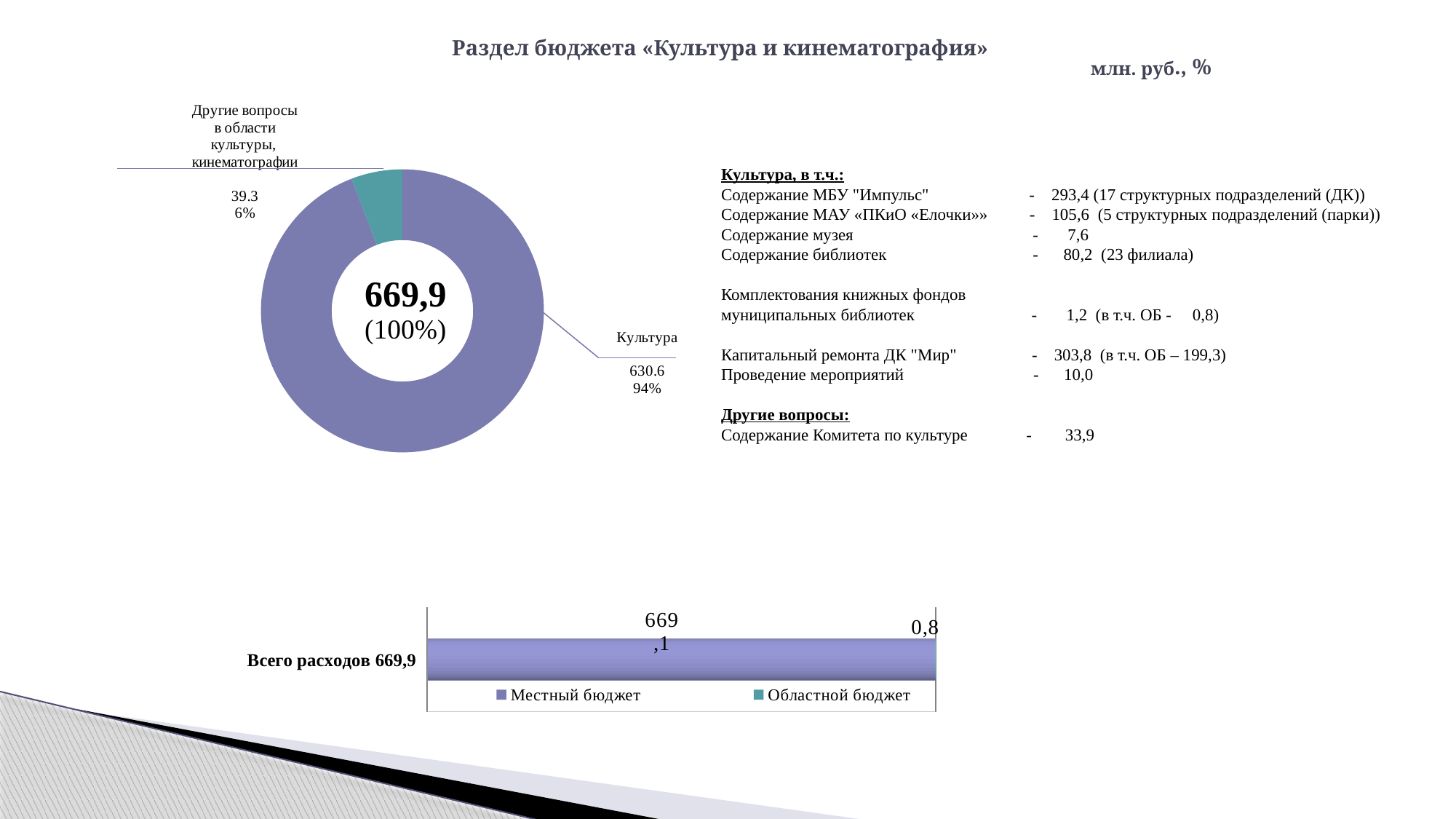
In the doughnut chart at the top left, what value is shown for the slice labelled Другие вопросы в области культуры, кинематографии? 39.3 In the doughnut chart at the top left, which slice is the largest? Культура In the doughnut chart at the top left, what total value is printed in the centre of the ring? 669,9 In the bar chart at the bottom, what value is shown for Местный бюджет? 669,1 In the bar chart at the bottom, what value is shown for Областной бюджет? 0,8 In the doughnut chart at the top left, how many slices are there? 2 What kind of chart is shown at the bottom of the slide? Bar chart In the doughnut chart at the top left, what value is shown for the Культура slice? 630.6 In the bar chart at the bottom, how many series does the legend list? 2 In the doughnut chart at the top left, what percentage share does the Культура slice have? 94% In the bar chart at the bottom, which series has the larger value, Местный бюджет or Областной бюджет? Местный бюджет In the doughnut chart at the top left, what percentage share does the Другие вопросы в области культуры, кинематографии slice have? 6%